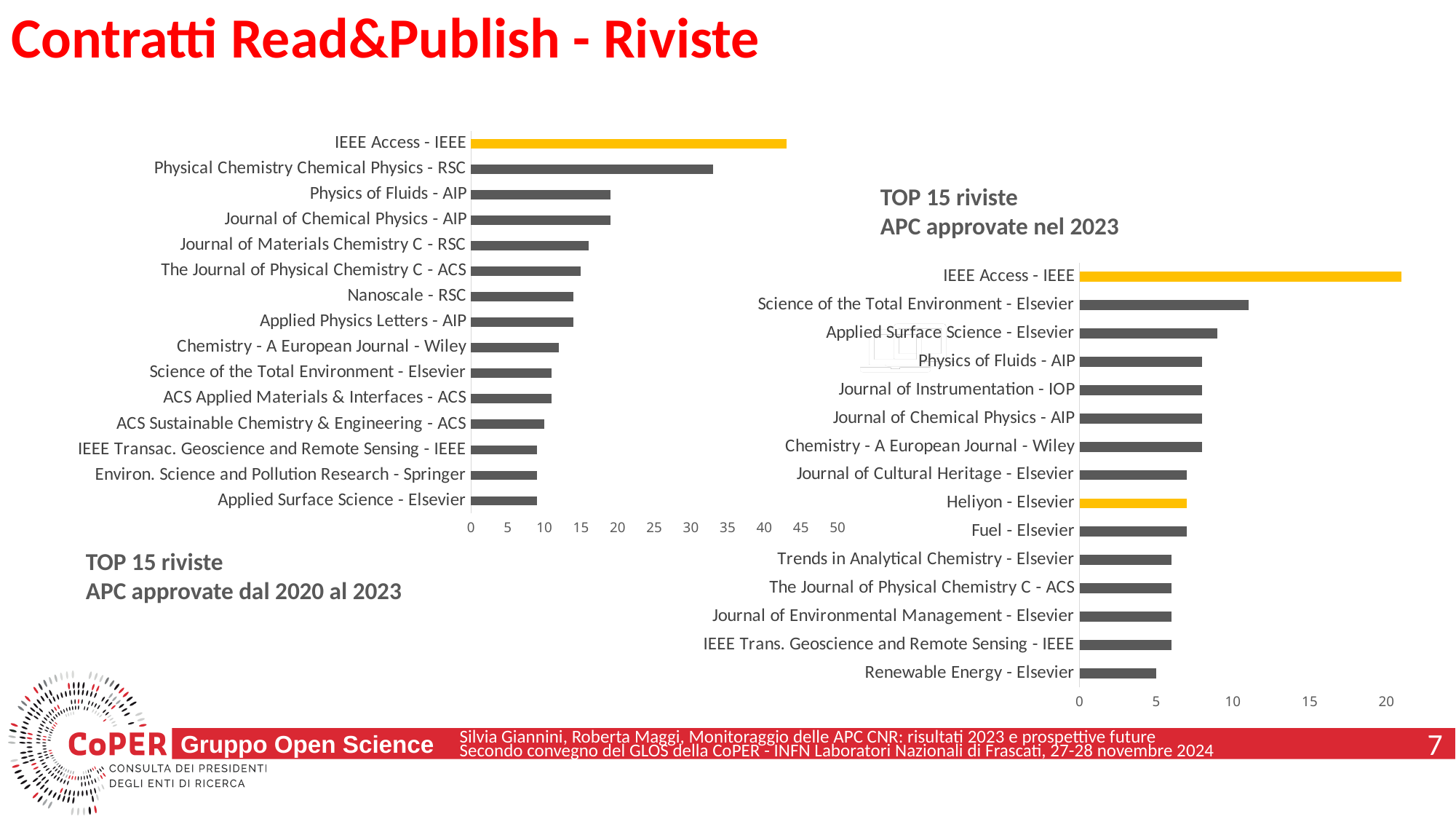
In the left chart (APC approvate dal 2020 al 2023), is the value for Physical Chemistry Chemical Physics - RSC greater or less than 30? greater In the left chart (APC approvate dal 2020 al 2023), is the value for IEEE Access - IEEE greater or less than 40? greater In the right chart (APC approvate nel 2023), which two journals have bars highlighted in yellow? IEEE Access - IEEE and Heliyon - Elsevier In the right chart (APC approvate nel 2023), which journal has the highest value? IEEE Access - IEEE In the left chart (APC approvate dal 2020 al 2023), which journal has the highest value? IEEE Access - IEEE What kind of chart is the left chart titled 'TOP 15 riviste APC approvate dal 2020 al 2023'? Bar chart In the right chart (APC approvate nel 2023), which is larger: the value for Science of the Total Environment - Elsevier or the value for Renewable Energy - Elsevier? Science of the Total Environment - Elsevier In the left chart (APC approvate dal 2020 al 2023), which is larger: the value for Physical Chemistry Chemical Physics - RSC or the value for Nanoscale - RSC? Physical Chemistry Chemical Physics - RSC How many journals are shown in the right chart titled 'TOP 15 riviste APC approvate nel 2023'? 15 In the right chart (APC approvate nel 2023), which journal has the lowest value? Renewable Energy - Elsevier